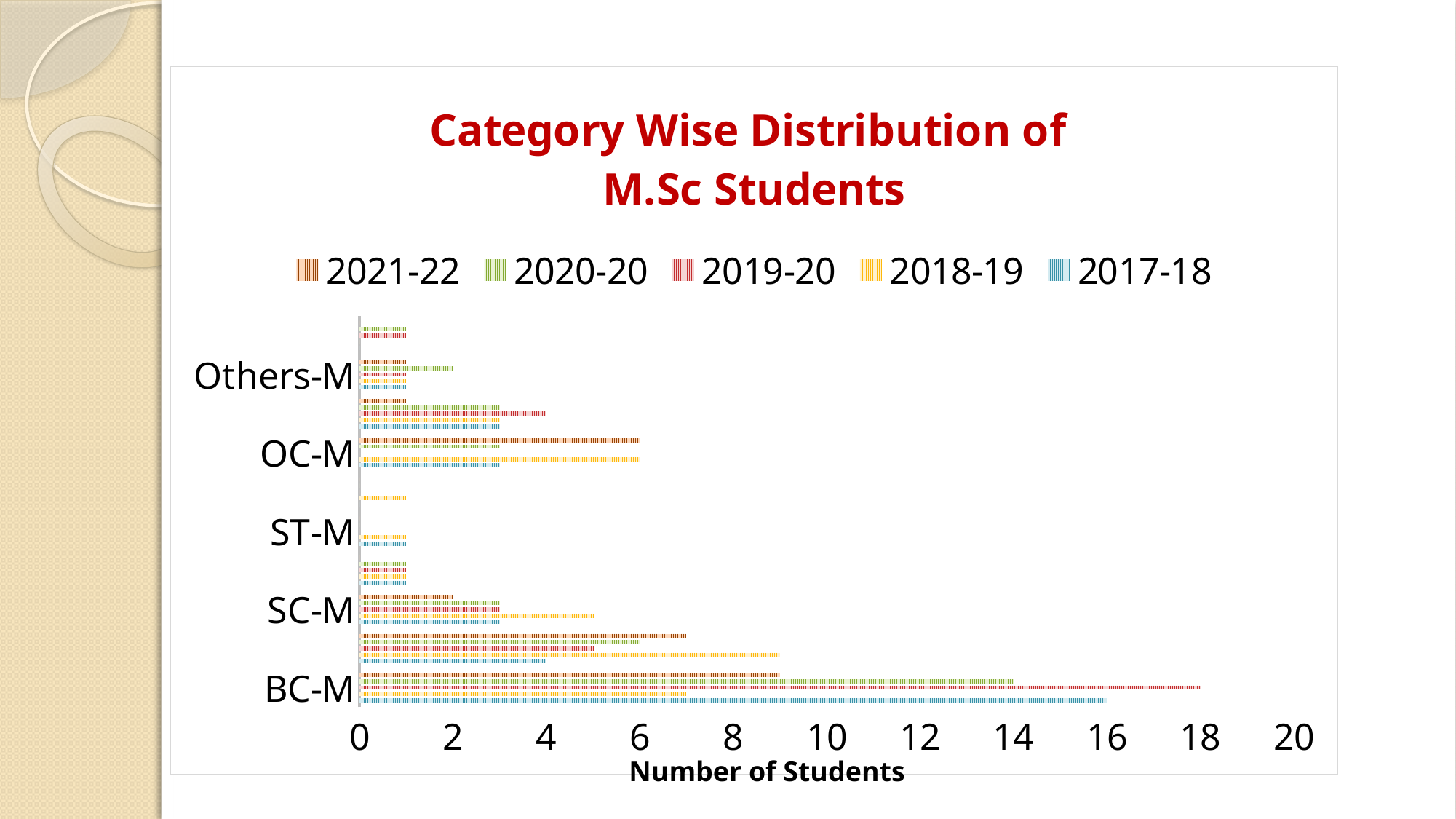
Is the value for BC-M in the 2017-18 series greater or less than 10? greater How many series does the legend list? 5 What is the label of the horizontal axis? Number of Students Which category has the lowest value for the 2021-22 series? ST-M What type of chart is shown on the slide? bar chart For OC-M, which series has the larger value: 2021-22 or 2020-20? 2021-22 What is the value for BC-M in the 2019-20 series? 18 What is the title of the chart? Category Wise Distribution of M.Sc Students For BC-M, which series has the larger value: 2019-20 or 2017-18? 2019-20 Is the value for OC-M in the 2021-22 series greater or less than 4? greater Is the value for SC-M in the 2018-19 series greater or less than 4? greater Which category has the highest value for the 2019-20 series? BC-M